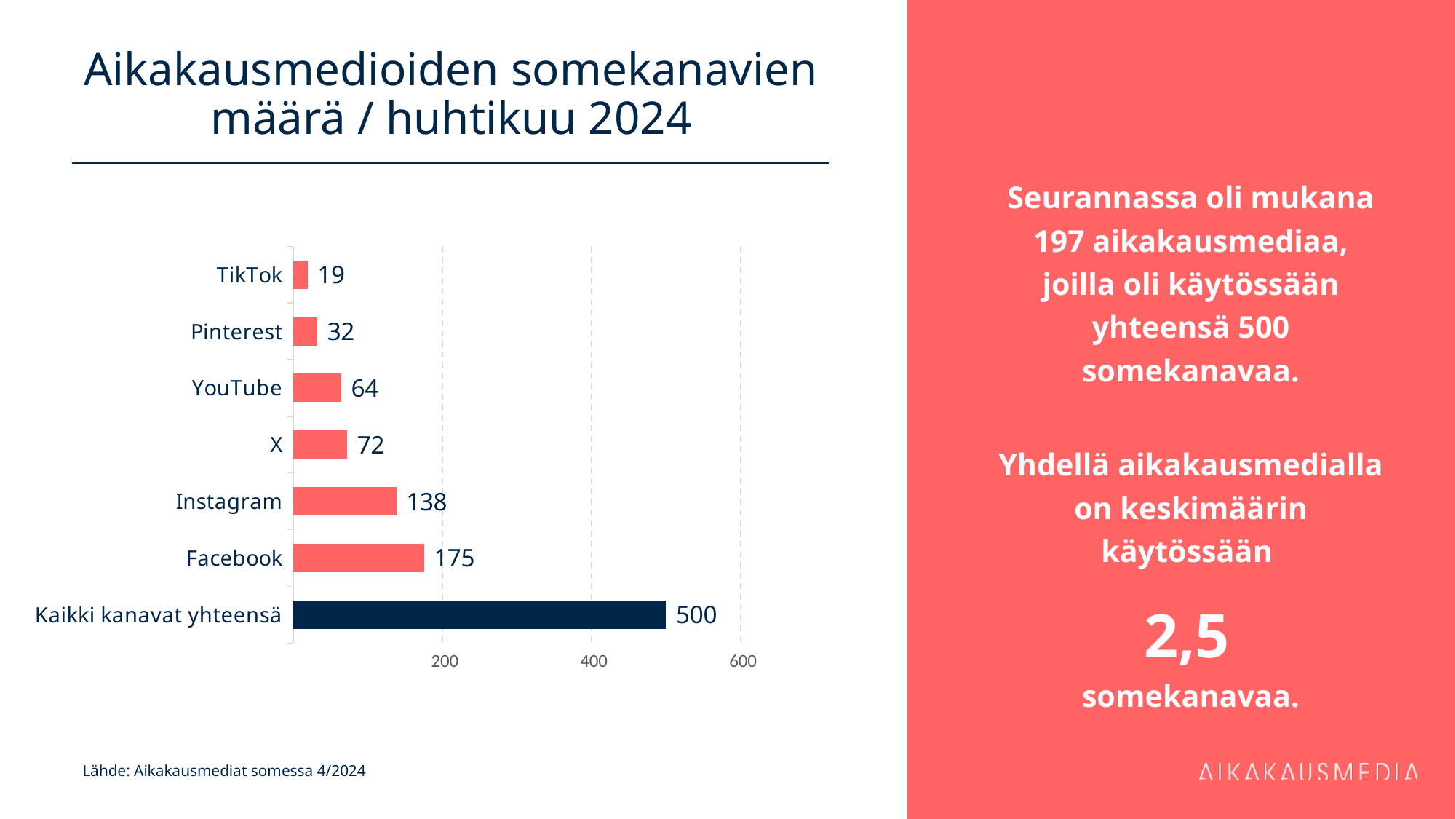
How many categories are shown in the chart? 7 What kind of chart is shown on the slide? Bar chart Which bar is shown in a different (dark navy) colour from the others? Kaikki kanavat yhteensä What is the value for Kaikki kanavat yhteensä? 500 Which is larger, the value for Pinterest or the value for YouTube? YouTube What is the value for Instagram? 138 What is the value for TikTok? 19 Which category has the lowest value? TikTok What is the difference between the values for X and YouTube? 8 What is the difference between the values for Facebook and Instagram? 37 What is the value for Facebook? 175 Which individual channel (excluding the total bar) has the highest value? Facebook